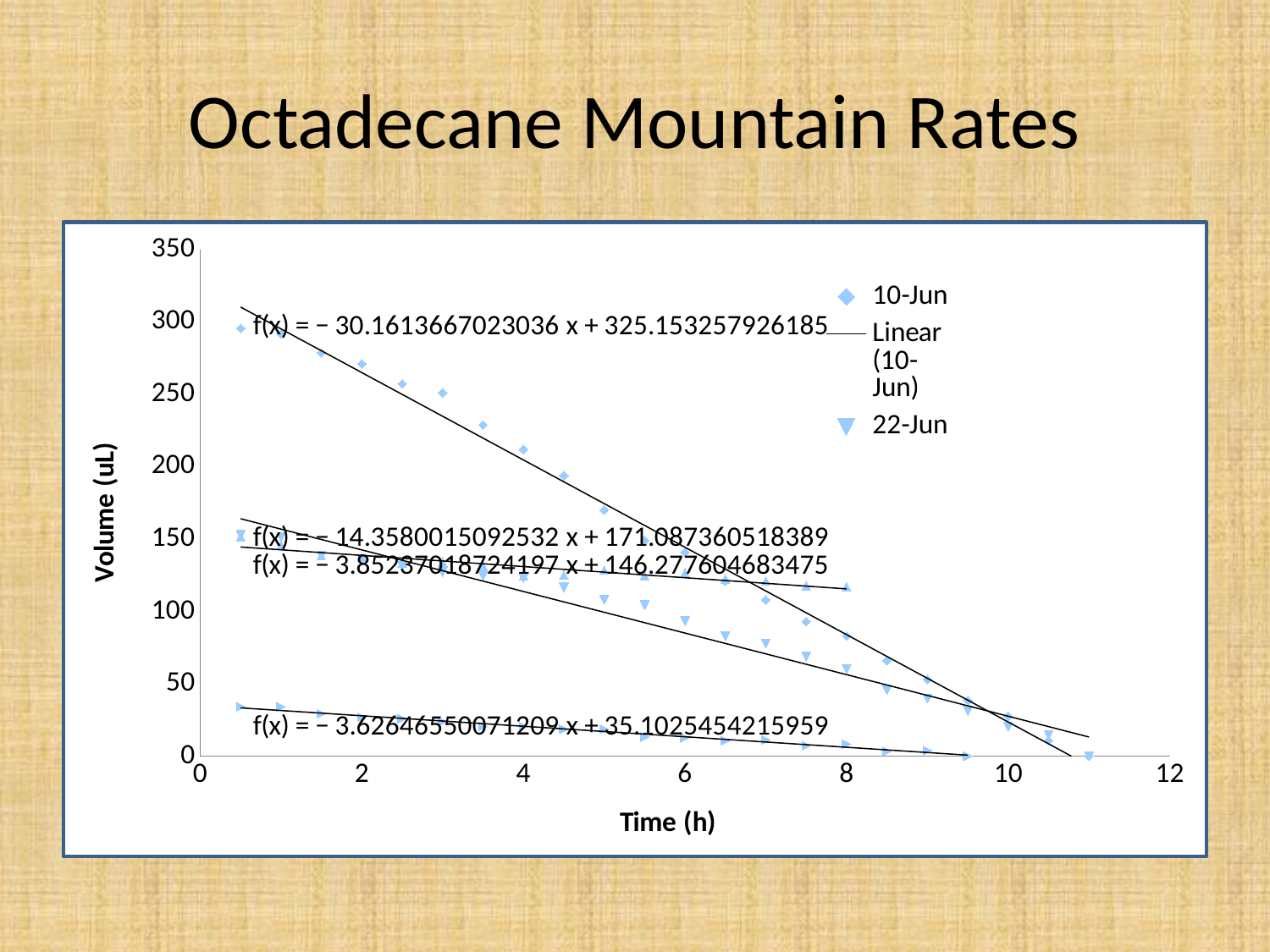
Is the 10-Jun value at time 10 h greater or less than 50? less What is the title of the slide's chart? Octadecane Mountain Rates What kind of chart is shown on the slide? scatter chart How many trendline equations are printed on the chart? 4 Is the 10-Jun value at time 0.5 h greater or less than 250? greater Do the 10-Jun values rise or fall as time increases along the x axis? fall Is the 10-Jun value at time 8 h greater or less than 100? less What is the intercept shown in the trendline equation f(x) = − 30.1613667023036 x + ...? 325.153257926185 What is the label on the y-axis of the chart? Volume (uL) What is the slope shown in the trendline equation for the topmost series? − 30.1613667023036 What is the intercept shown in the trendline equation with slope − 3.62646550071209? 35.1025454215959 What is the highest value shown on the y-axis of the chart? 350